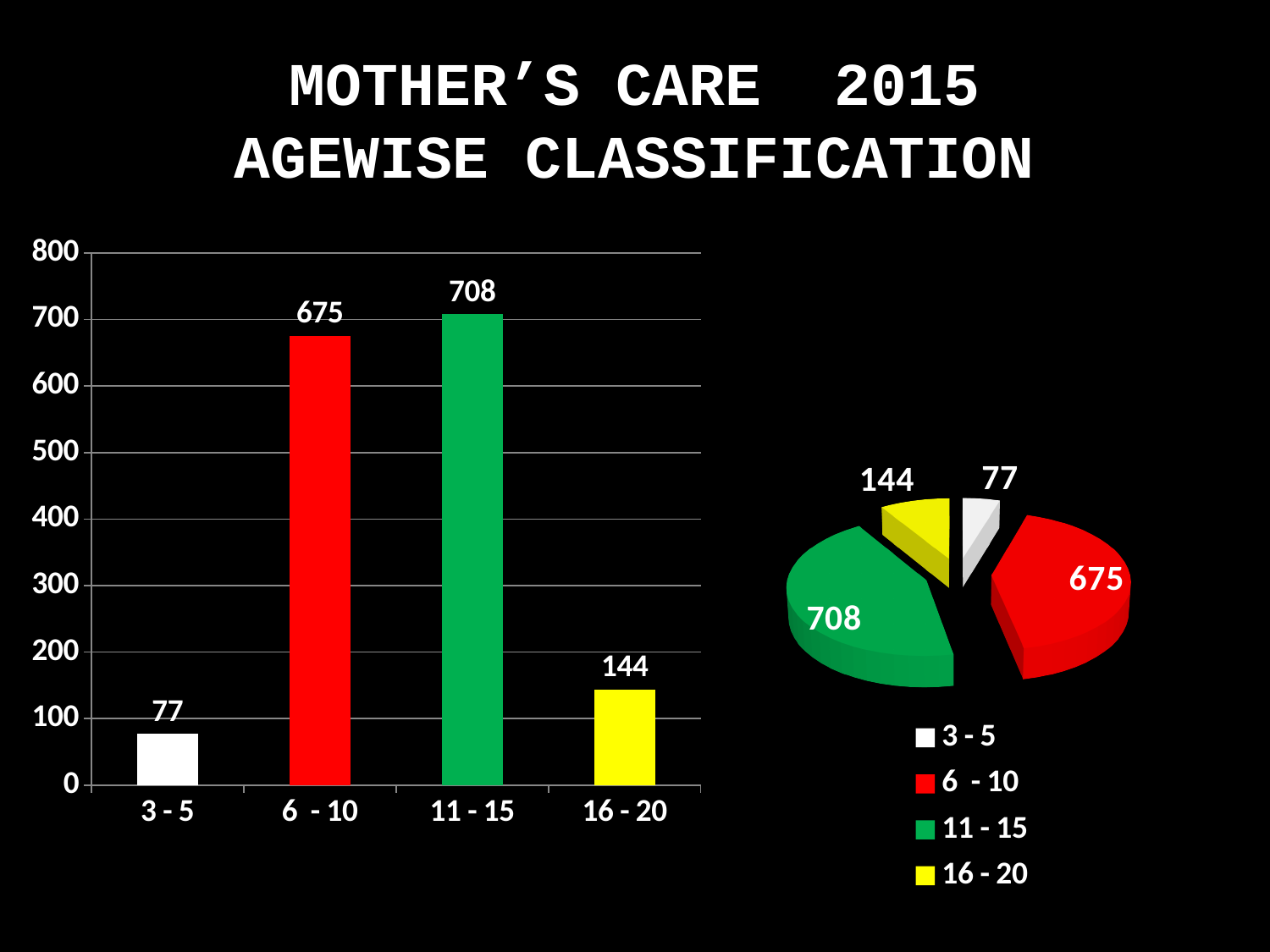
In the bar chart on the left, which age group has the lowest value? 3 - 5 In the bar chart on the left, what is the difference between the values for 11 - 15 and 6 - 10? 33 In the pie chart on the right, what value is shown for the 16 - 20 slice? 144 In the pie chart on the right, which is larger, the 6 - 10 slice or the 16 - 20 slice? 6 - 10 In the bar chart on the left, which age group has the highest value? 11 - 15 How many age groups are shown in the bar chart on the left? 4 In the pie chart on the right, what colour is the 11 - 15 slice? Green In the bar chart on the left, what is the value for the 3 - 5 age group? 77 In the bar chart on the left, is the value for 6 - 10 greater or less than 600? greater In the bar chart on the left, what is the difference between the values for 16 - 20 and 3 - 5? 67 What kind of chart is the chart on the right of the slide? Pie chart In the bar chart on the left, what is the value for the 11 - 15 age group? 708